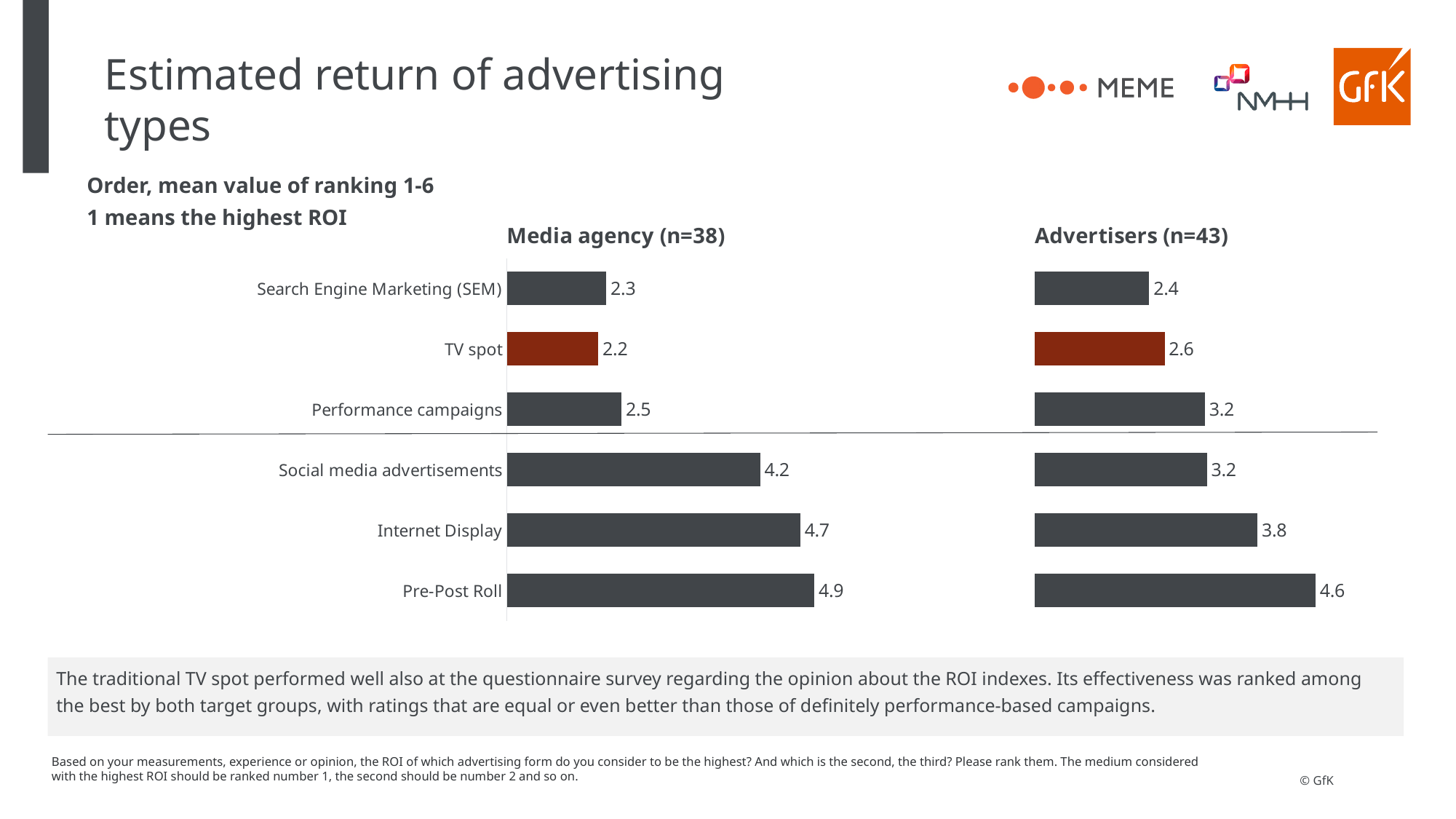
In the Media agency (n=38) chart, which category has the highest value? Pre-Post Roll In the Media agency (n=38) chart, what is the difference between the values for Pre-Post Roll and Social media advertisements? 0.7 In the Advertisers (n=43) chart, which category has the highest value? Pre-Post Roll What kind of chart is the Advertisers (n=43) chart? Bar chart In the Media agency (n=38) chart, which category has the lowest value? TV spot In the Advertisers (n=43) chart, what is the value for Internet Display? 3.8 In the Advertisers (n=43) chart, which category has the lowest value? Search Engine Marketing (SEM) In the Media agency (n=38) chart, which category's bar is coloured differently (dark red) from the others? TV spot Which is larger: the value for TV spot in the Media agency (n=38) chart or in the Advertisers (n=43) chart? Advertisers (n=43) How many categories are shown in the Media agency (n=38) chart? 6 In the Advertisers (n=43) chart, what is the value for Search Engine Marketing (SEM)? 2.4 In the Media agency (n=38) chart, what is the value for TV spot? 2.2